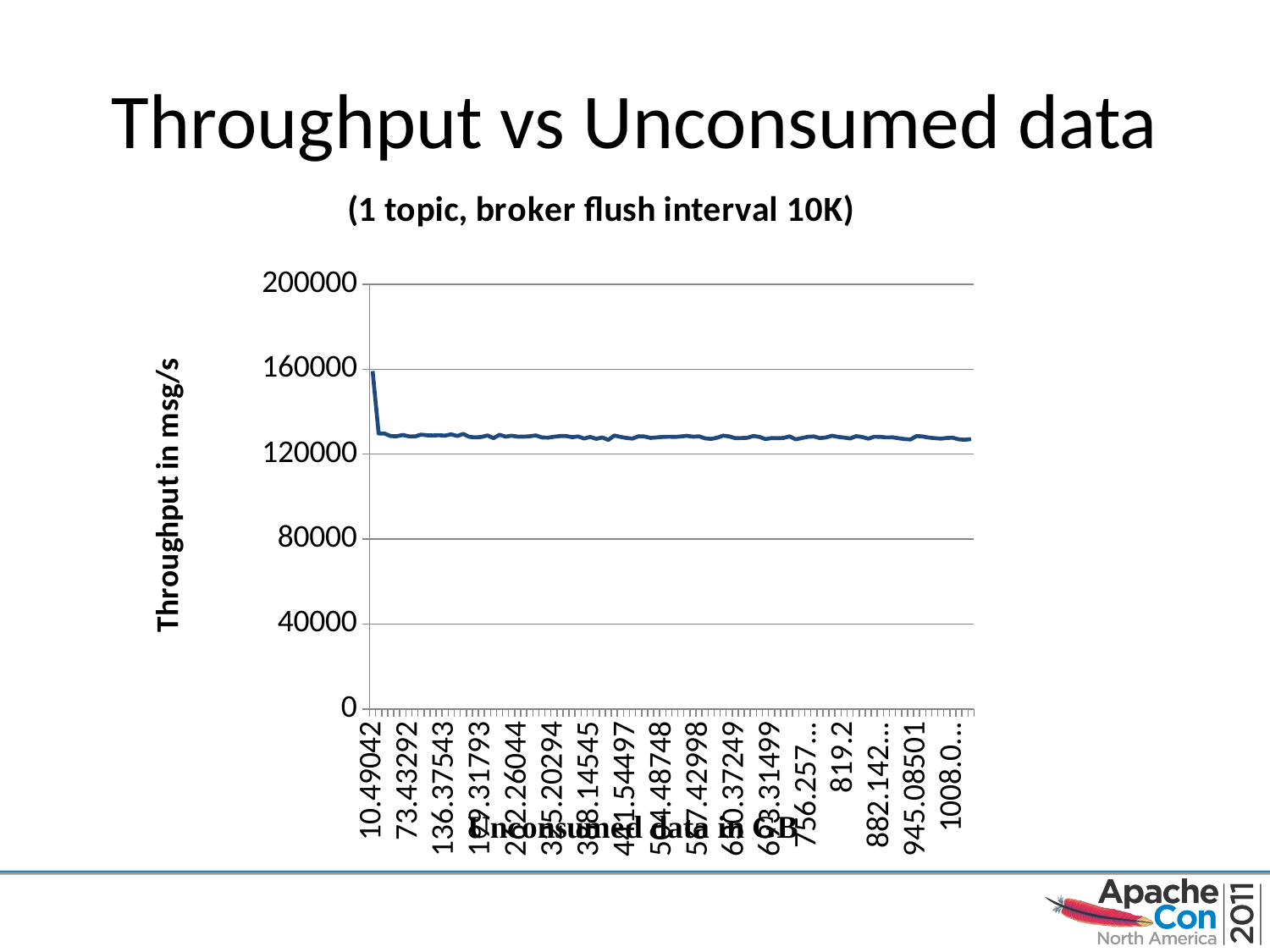
Which is larger, the throughput at 10.49042 GB or at 73.43292 GB of unconsumed data? 10.49042 Is the throughput at 819.2 GB of unconsumed data greater or less than 120000? greater At which x-axis value is the throughput highest? 10.49042 After the initial drop, does the throughput rise sharply, fall sharply, or stay roughly flat along the x axis? stay roughly flat Is the throughput at the first x-axis point (10.49042) greater or less than 120000? greater Does the throughput rise or fall between the first and second x-axis points? fall Is the throughput at 819.2 GB of unconsumed data greater or less than 160000? less What is the label of the x axis of the chart? Unconsumed data in GB What kind of chart is shown on the slide? line chart What is the label of the y axis of the chart? Throughput in msg/s